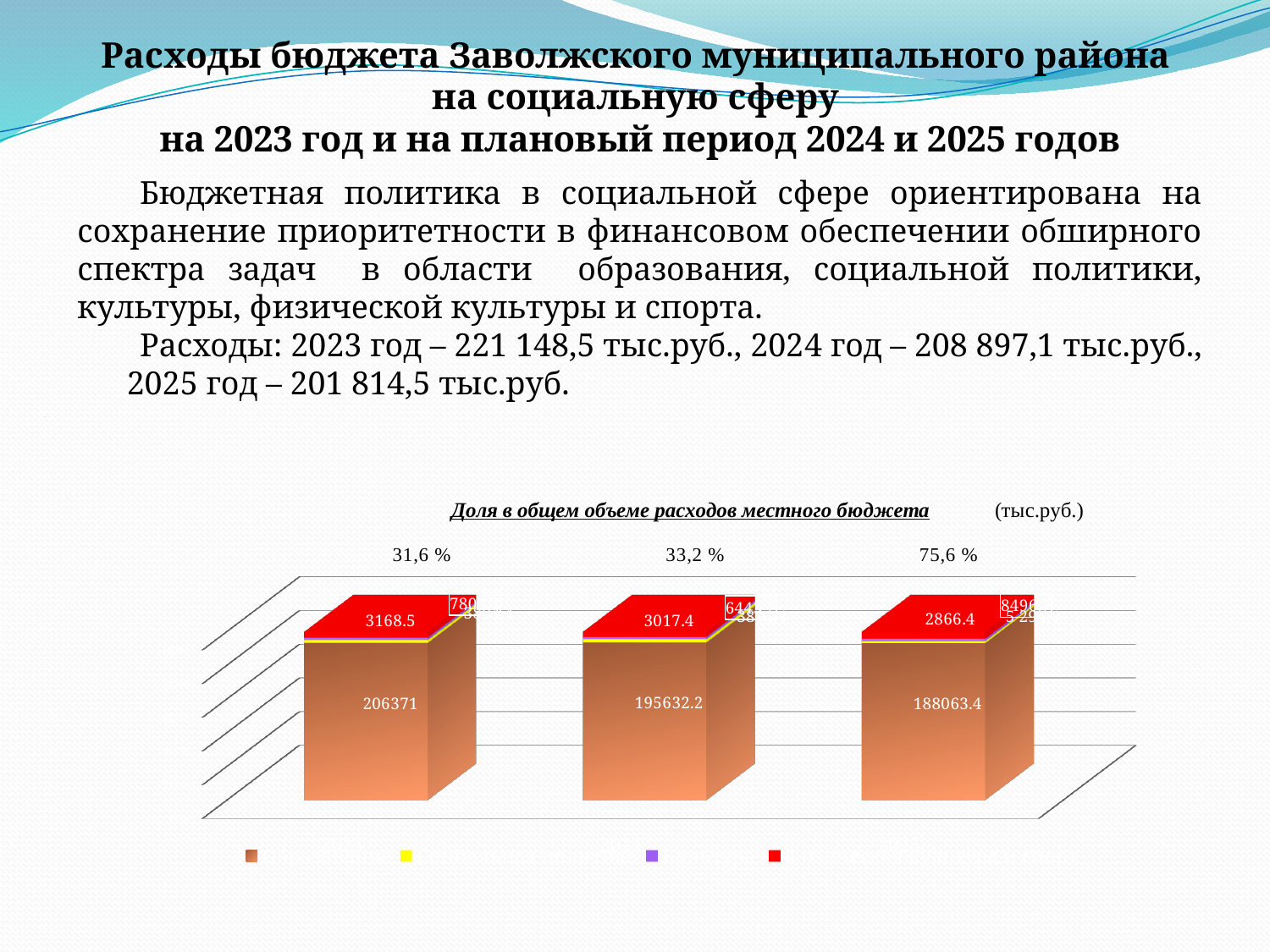
How many series does the chart legend list? 4 What percentage is printed above the left bar? 31,6 % Do the values of the brown bottom segments rise or fall from the left bar to the right bar? fall How many bars are plotted in the chart? 3 Which bar has the largest brown bottom segment: left, middle or right? left What is the value of the large brown bottom segment of the middle bar? 195632.2 What is the value of the large brown bottom segment of the right bar? 188063.4 What kind of chart is shown on the slide? bar chart What is the difference between the brown bottom segments of the left bar and the right bar? 18307.6 What is the value of the large brown bottom segment of the left bar? 206371